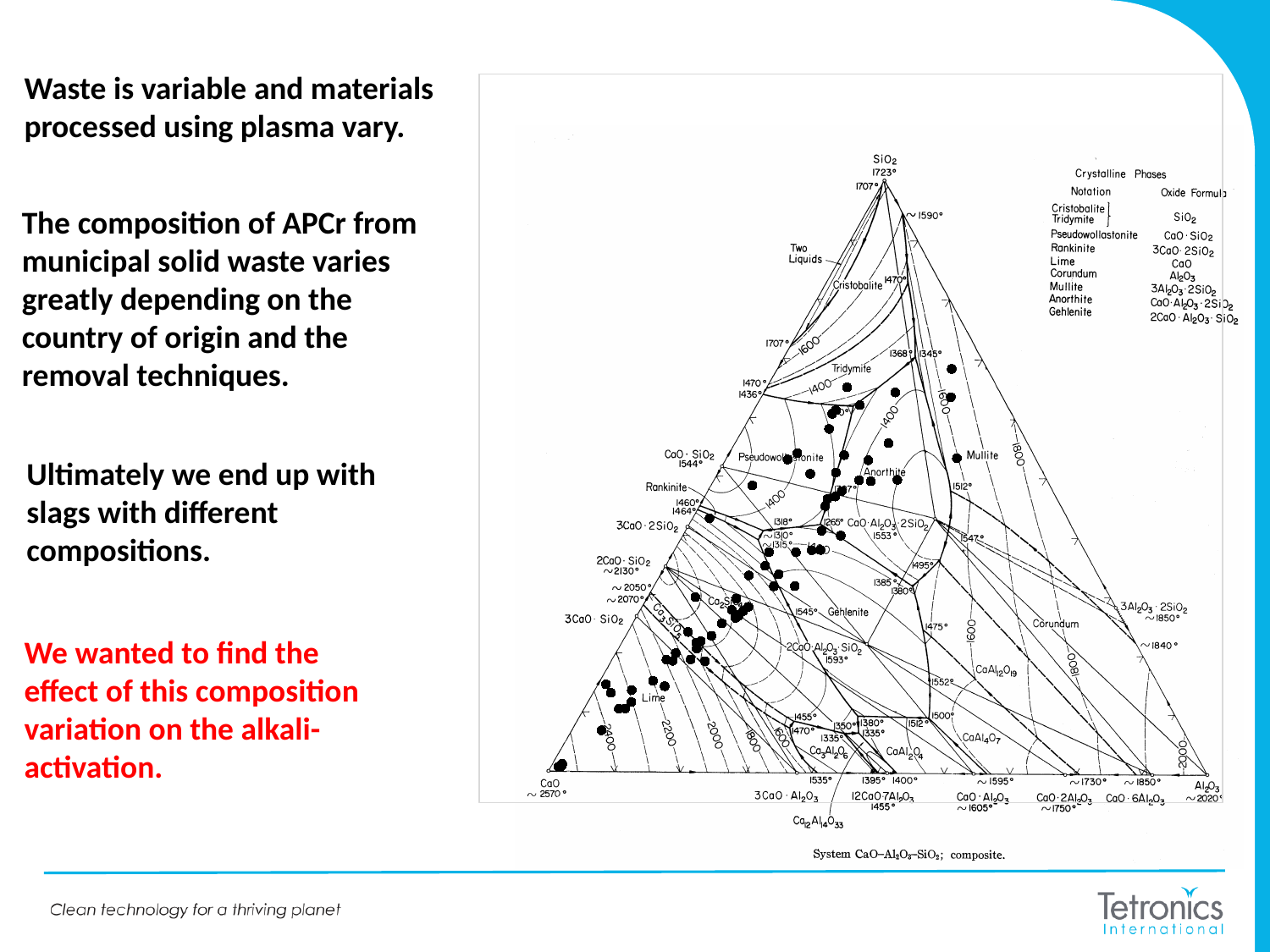
What temperature is printed at the SiO2 apex of the diagram? 1723° What temperature is printed at the Al2O3 corner of the diagram? ~2020° Is the printed temperature at the CaO corner greater or less than the printed temperature at the Al2O3 corner? greater What kind of chart is shown on the slide? Ternary phase diagram What temperature is printed at the CaO corner of the diagram? ~2570° What temperature is printed next to CaO·SiO2 on the left edge of the diagram? 1544° What temperature is printed next to CaO·Al2O3·2SiO2 (anorthite) inside the diagram? 1553° What temperature is printed next to 3Al2O3·2SiO2 on the right edge of the diagram? ~1850° Which of the three corner oxides has the lowest printed temperature? SiO2 According to the Crystalline Phases legend, what is the oxide formula for Mullite? 3Al2O3·2SiO2 Which of the three corner oxides has the highest printed temperature? CaO What system does the caption below the diagram say is plotted? System CaO–Al2O3–SiO2; composite.